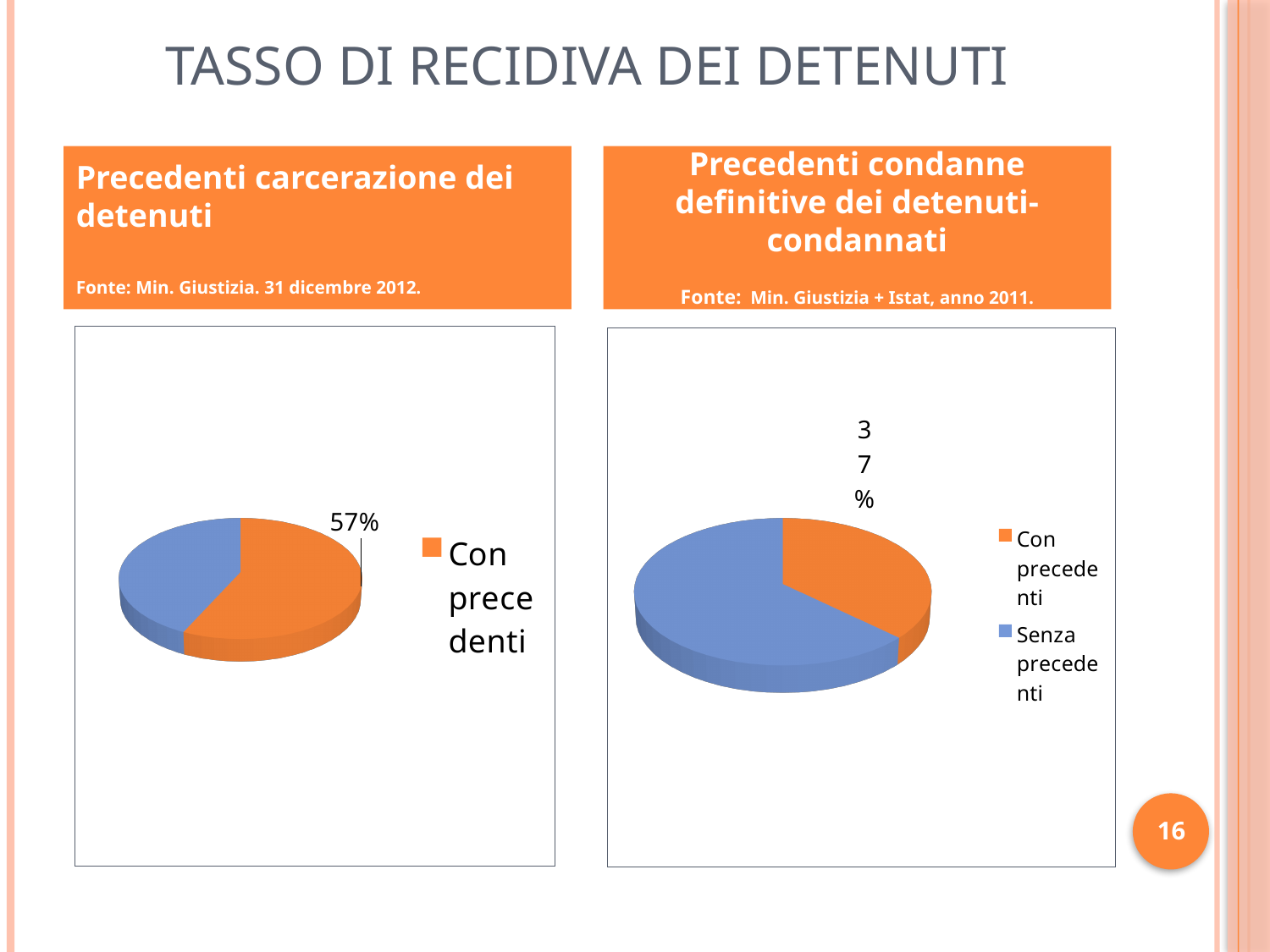
How many slices does the right pie chart (Precedenti condanne definitive dei detenuti-condannati) have? 2 In the right pie chart (Precedenti condanne definitive dei detenuti-condannati), which slice is larger, 'Con precedenti' or 'Senza precedenti'? Senza precedenti What kind of chart is the right chart (Precedenti condanne definitive dei detenuti-condannati)? Pie chart In the right pie chart (Precedenti condanne definitive dei detenuti-condannati), what percentage is shown for the 'Con precedenti' slice? 37% What kind of chart is the left chart (Precedenti carcerazione dei detenuti)? Pie chart What is the difference between the 'Con precedenti' share in the left pie chart (57%) and the 'Con precedenti' share in the right pie chart (37%)? 20 percentage points In the left pie chart (Precedenti carcerazione dei detenuti), is the orange 'Con precedenti' slice larger or smaller than the blue slice? Larger How many legend entries does the left pie chart (Precedenti carcerazione dei detenuti) list? 1 What is the title of the right chart? Precedenti condanne definitive dei detenuti-condannati What source is cited for the left chart (Precedenti carcerazione dei detenuti)? Min. Giustizia. 31 dicembre 2012. In the left pie chart (Precedenti carcerazione dei detenuti), what percentage is shown for the 'Con precedenti' slice? 57% How many legend entries does the right pie chart (Precedenti condanne definitive dei detenuti-condannati) list? 2